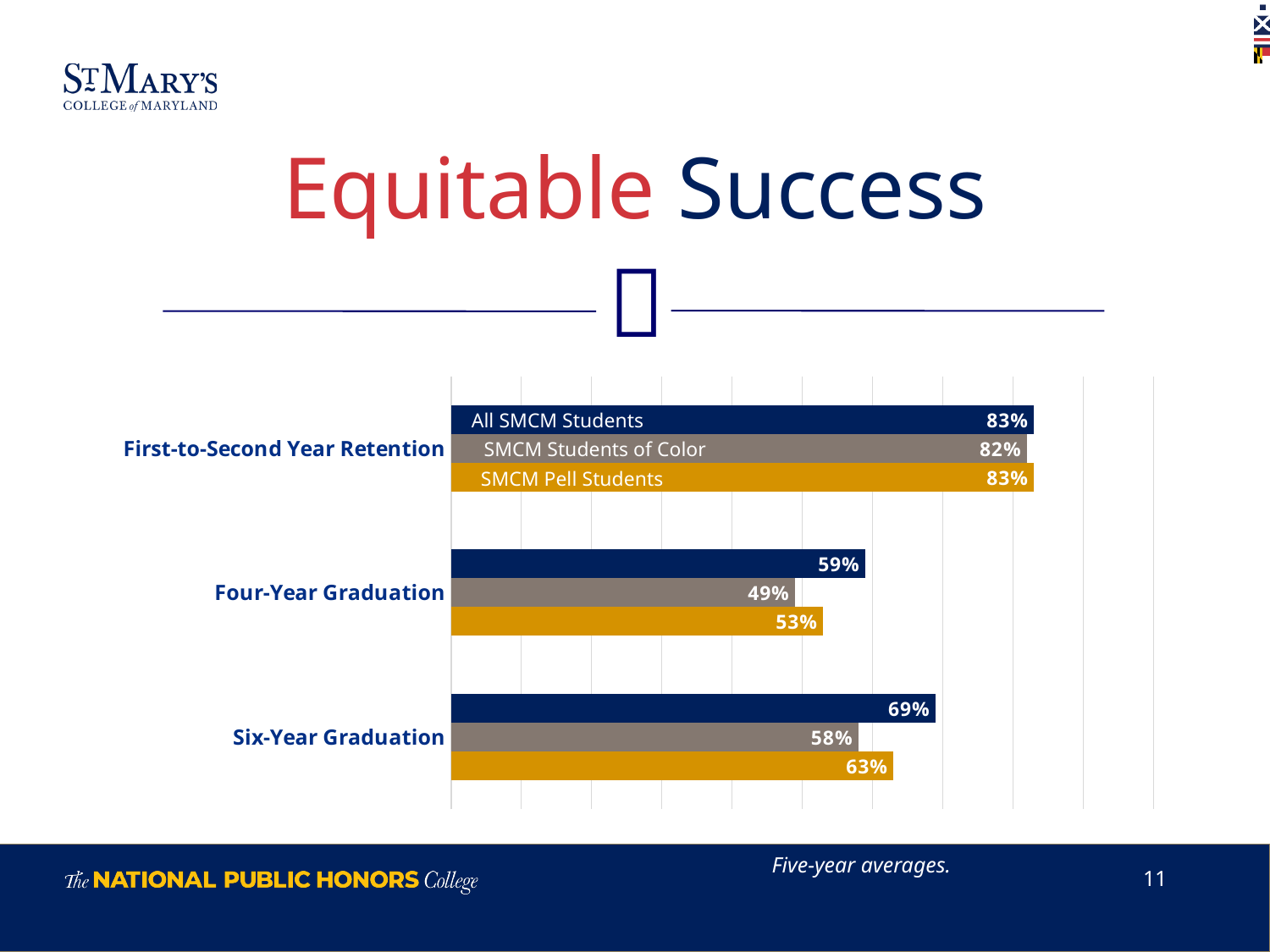
Which group has the lowest Four-Year Graduation rate? SMCM Students of Color Which category has the highest value for SMCM Pell Students? First-to-Second Year Retention What is the difference between the Six-Year Graduation rates of All SMCM Students and SMCM Students of Color? 11% How many student groups (series) are shown in the chart? 3 What is the First-to-Second Year Retention rate for All SMCM Students? 83% What type of chart is shown on the slide? Bar chart How many categories are shown on the chart? 3 What is the difference between the Four-Year Graduation rates of All SMCM Students and SMCM Pell Students? 6% What is the Six-Year Graduation rate for SMCM Pell Students? 63% Which is larger: the Four-Year Graduation rate for SMCM Pell Students or for SMCM Students of Color? SMCM Pell Students What is the Four-Year Graduation rate for SMCM Students of Color? 49% What is the Six-Year Graduation rate for All SMCM Students? 69%